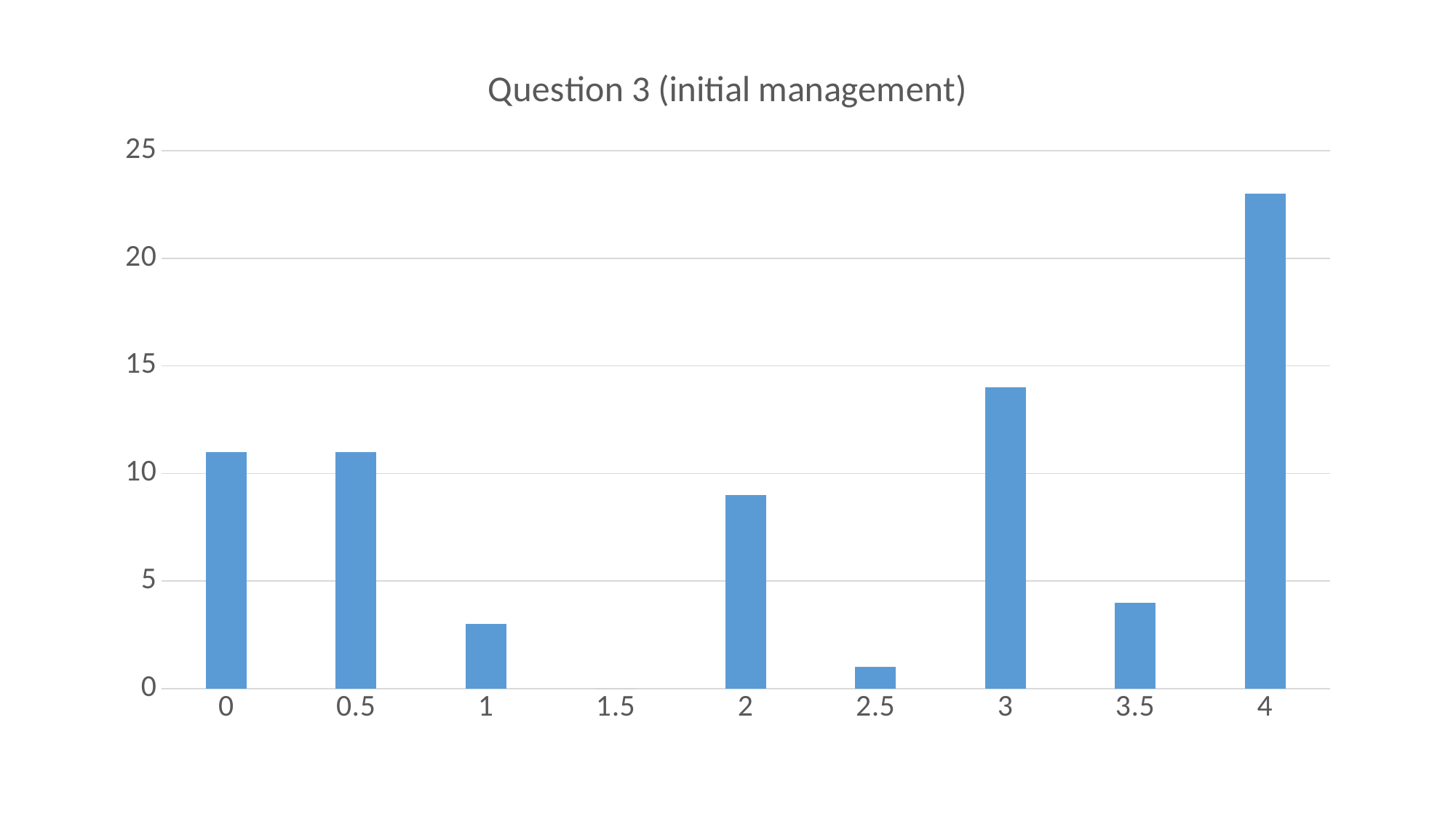
Which category has the highest bar? 4 Which has the larger value, category 4 or category 3? 4 Is the value for category 3.5 greater or less than 5? less Is the value for category 1 greater or less than 5? less How many categories are shown on the x axis? 9 Which category has the lowest value (no visible bar)? 1.5 Is the value for category 3 greater or less than 10? greater Which has the larger value, category 3 or category 2? 3 What is the title of the chart? Question 3 (initial management) What kind of chart is shown on the slide? bar chart